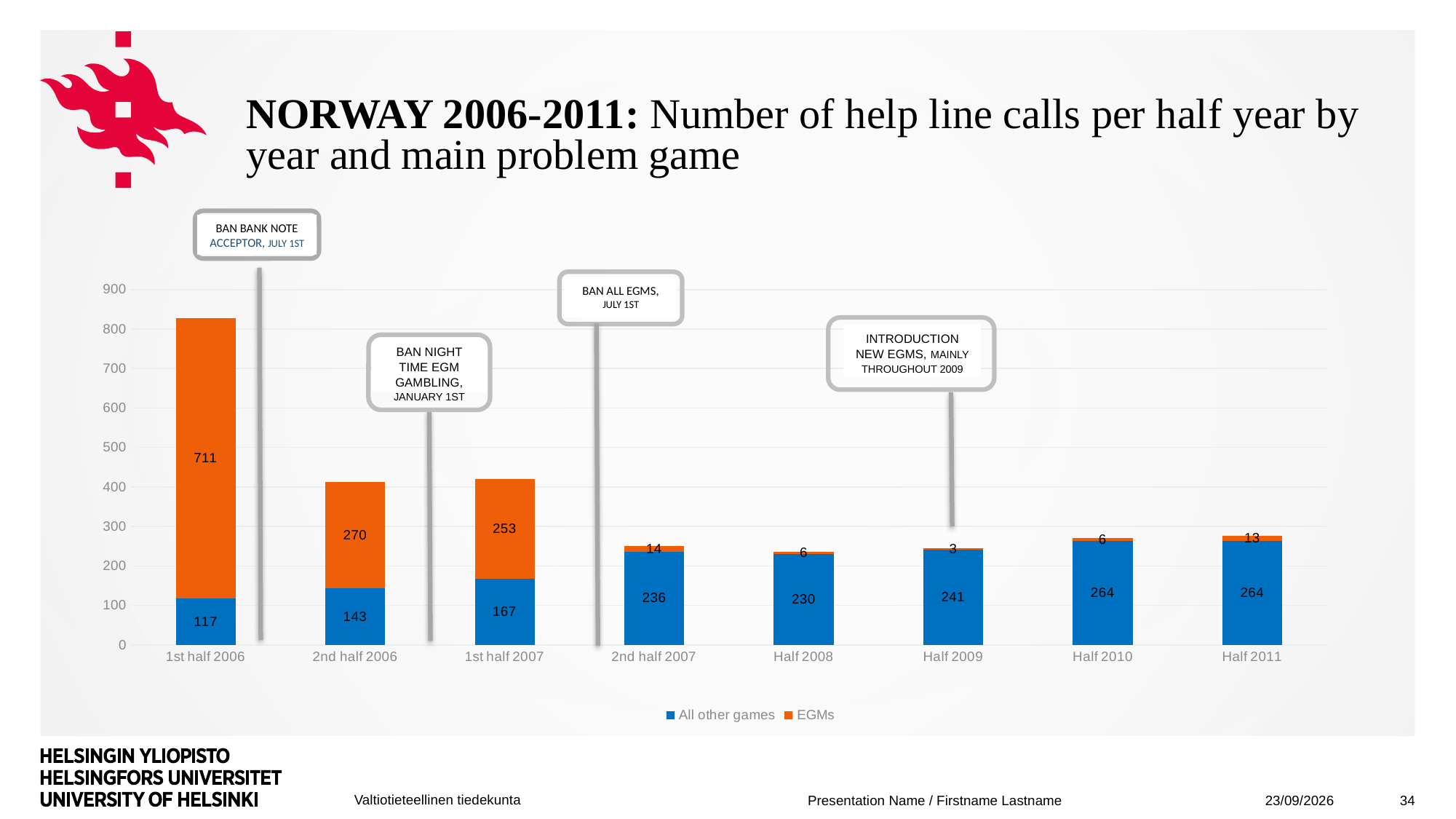
What is the difference between the EGMs values for 2nd half 2006 and 1st half 2007? 17 Which category has the lowest value for EGMs? Half 2009 How many categories are shown on the x axis? 8 Which category has the highest value for EGMs? 1st half 2006 What is the value for All other games in Half 2009? 241 What is the total of the stacked bar for Half 2010? 270 Which is larger: All other games in 2nd half 2007 or All other games in Half 2008? 2nd half 2007 What is the value for EGMs in 1st half 2006? 711 What is the total of the stacked bar for 1st half 2006? 828 How many series does the legend list? 2 What is the value for EGMs in Half 2011? 13 Which category has the lowest value for All other games? 1st half 2006